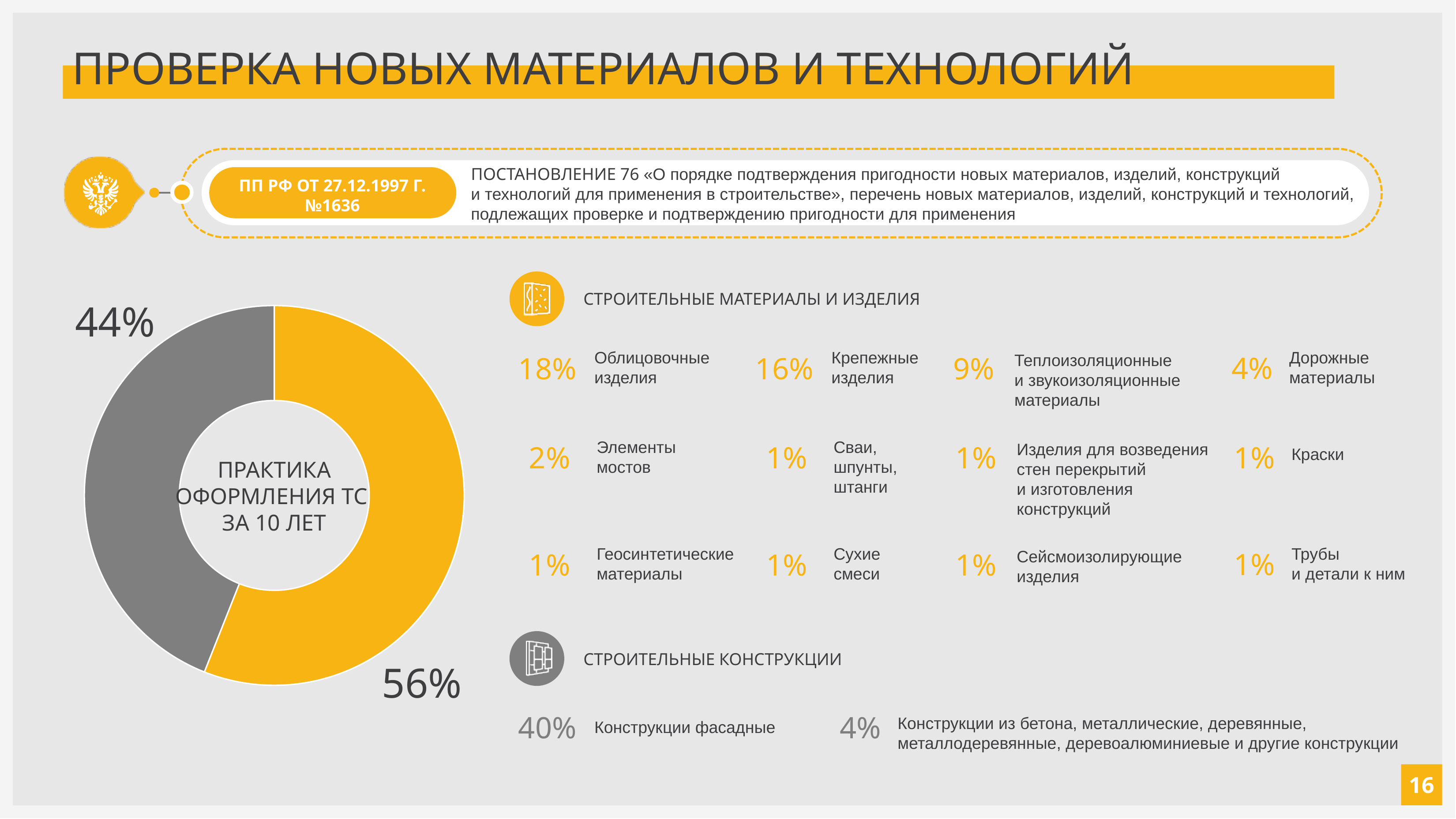
What value is labelled on the yellow slice of the donut chart? 56% What text is written in the centre of the donut chart? ПРАКТИКА ОФОРМЛЕНИЯ ТС ЗА 10 ЛЕТ What two colours are used for the slices of the donut chart? Yellow and grey What value is labelled on the grey slice of the donut chart? 44% What kind of chart is shown on the left of the slide? Pie (donut) chart Is the value of the grey slice in the donut chart greater or less than 50%? less What share of the donut chart does the yellow slice represent? 56% Which slice of the donut chart is the smallest? The grey slice (44%) Which is larger in the donut chart, the yellow slice or the grey slice? The yellow slice What is the difference between the two slices of the donut chart? 12% Which slice of the donut chart is the largest? The yellow slice (56%) How many slices does the donut chart have? 2